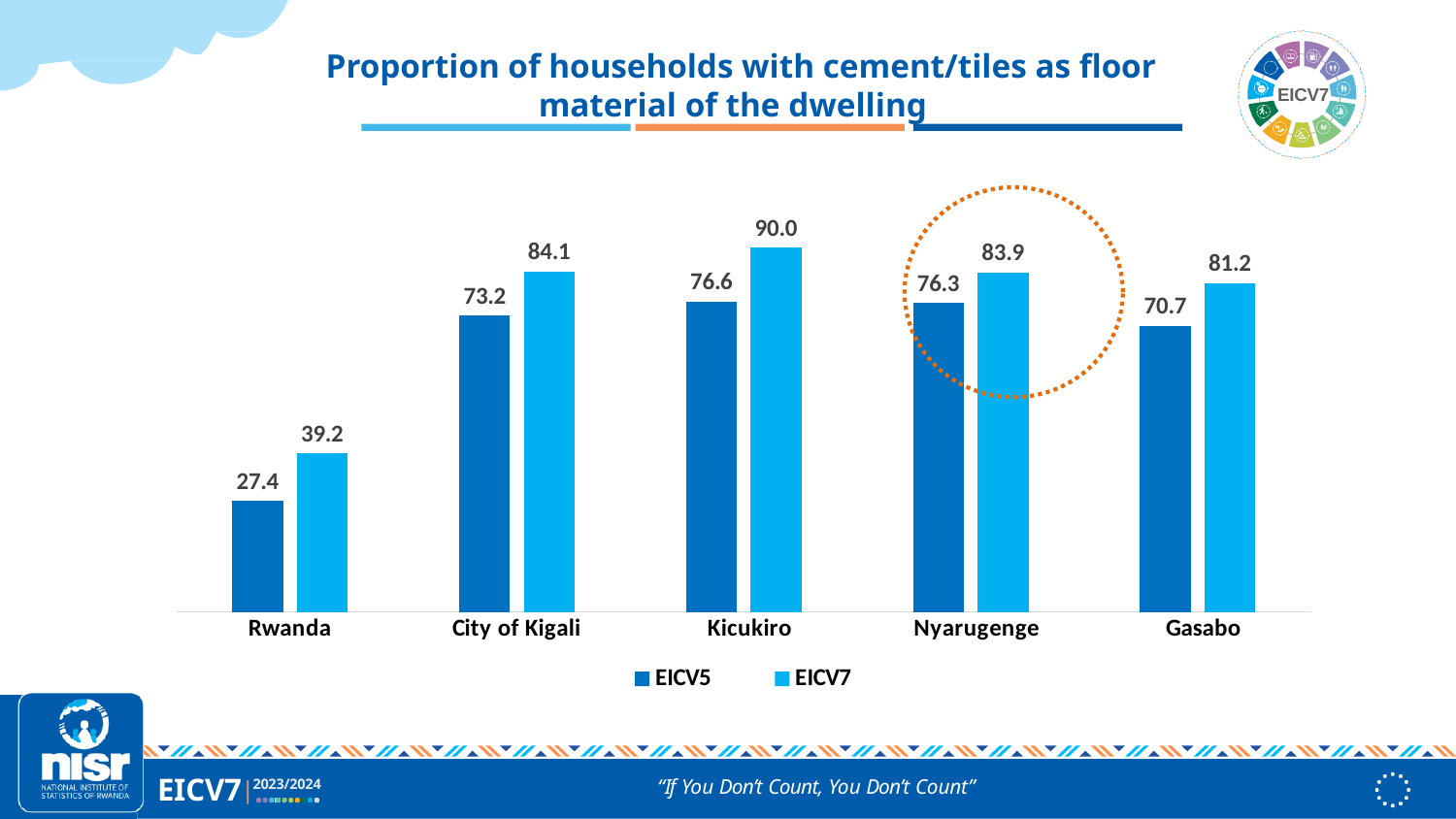
Which category is highlighted with a dashed orange circle? Nyarugenge What is the difference between the EICV7 and EICV5 values for Rwanda? 11.8 What is the EICV5 value for Rwanda? 27.4 What is the difference between the EICV7 and EICV5 values for City of Kigali? 10.9 What is the EICV7 value for Nyarugenge? 83.9 How many categories are shown on the x axis? 5 How many series does the legend list? 2 Which is larger, the EICV5 value for Kicukiro or the EICV5 value for Gasabo? Kicukiro What is the EICV7 value for Kicukiro? 90.0 Which category has the highest EICV7 value? Kicukiro What kind of chart is shown on the slide? Bar chart Which category has the lowest EICV5 value? Rwanda